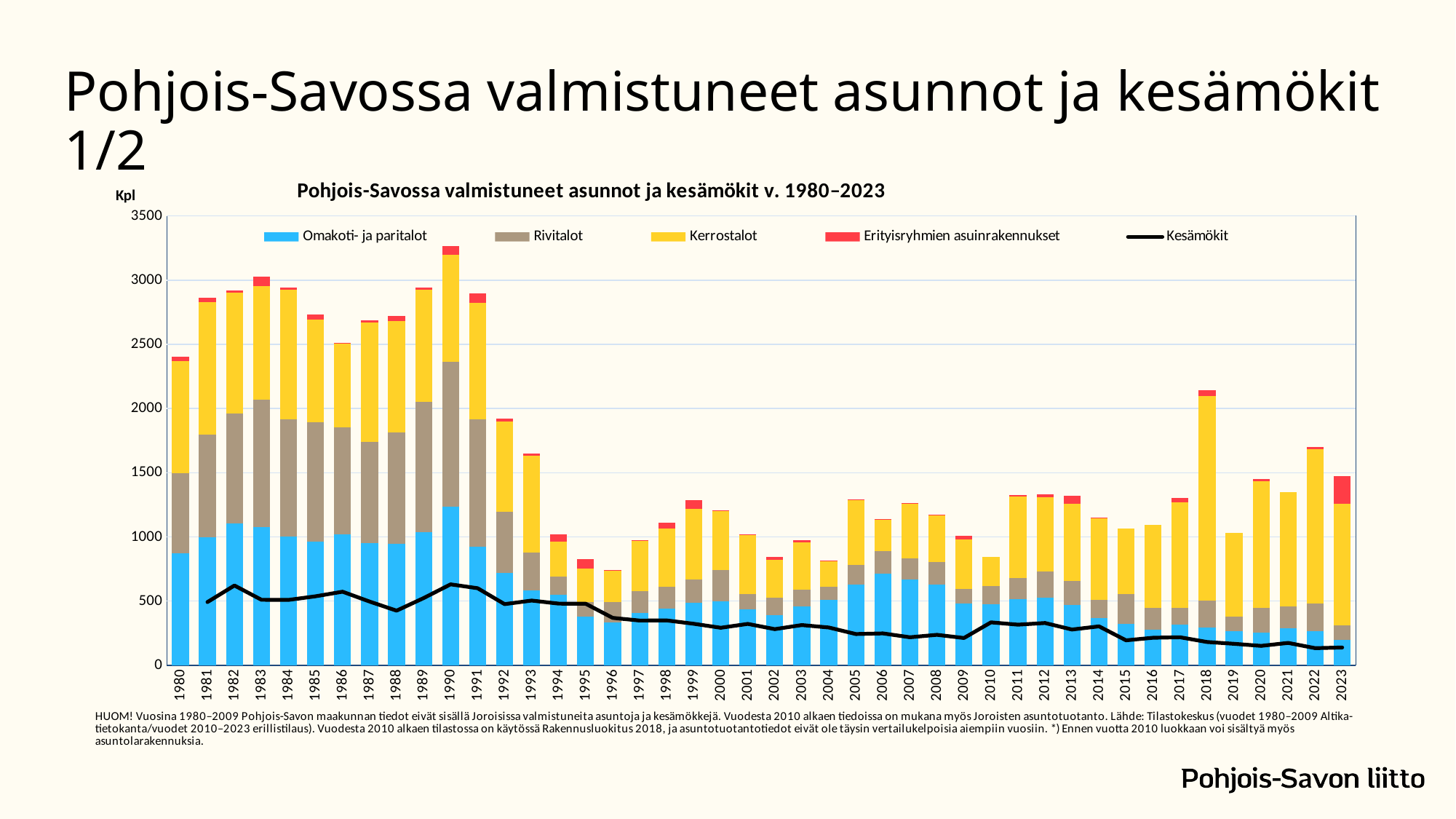
Does the Kesämökit line generally rise or fall from 1980 to 2023? fall Is the Kesämökit value for 1982 greater or less than 500? greater What colour represents Kerrostalot in the chart legend? yellow Is the Kesämökit value for 2023 greater or less than 500? less Is the total stacked bar for 1990 greater or less than 3000? greater Which year has the highest total stacked bar? 1990 How many years are shown on the x axis of the chart? 44 What kind of chart is shown on the slide? stacked bar chart with a line How many series does the chart legend list? 5 Which year has the larger total stacked bar, 2018 or 2022? 2018